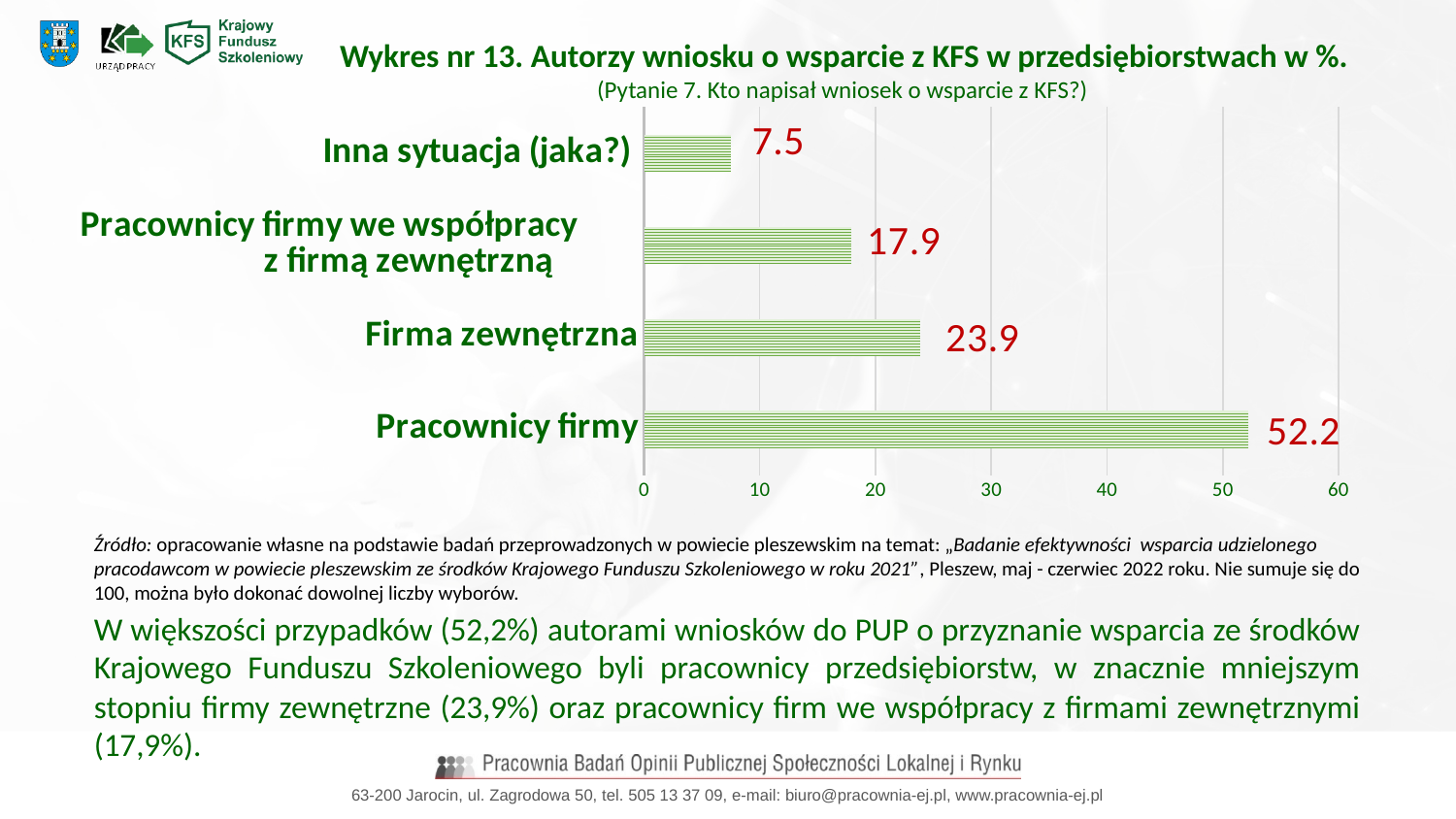
What is the value for "Firma zewnętrzna"? 23.9 What is the value for "Inna sytuacja (jaka?)"? 7.5 Which category has the lowest value? Inna sytuacja (jaka?) Is the value for "Pracownicy firmy" greater or less than 50? greater What is the value for "Pracownicy firmy"? 52.2 What is the value for "Pracownicy firmy we współpracy z firmą zewnętrzną"? 17.9 Which is larger: the value for "Firma zewnętrzna" or for "Inna sytuacja (jaka?)"? Firma zewnętrzna What is the difference between the values for "Pracownicy firmy" and "Firma zewnętrzna"? 28.3 How many categories are shown in the chart? 4 What kind of chart is shown on the slide? bar chart Which category has the highest value? Pracownicy firmy What is the difference between the values for "Firma zewnętrzna" and "Pracownicy firmy we współpracy z firmą zewnętrzną"? 6